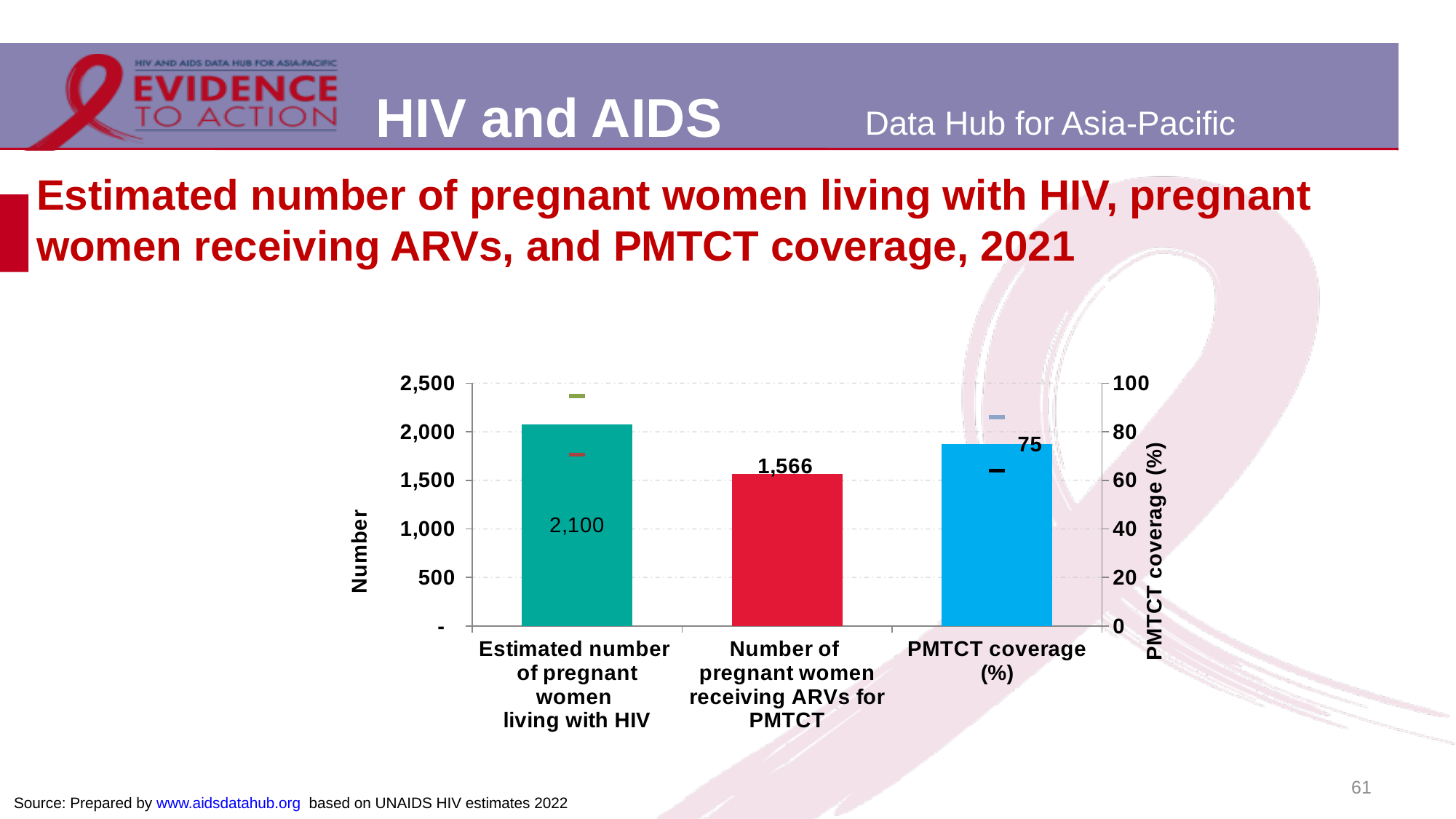
What is the PMTCT coverage (%) value shown on the chart? 75 What is the number of pregnant women receiving ARVs for PMTCT shown on the chart? 1,566 Which is larger: the estimated number of pregnant women living with HIV or the number of pregnant women receiving ARVs for PMTCT? Estimated number of pregnant women living with HIV Is the number of pregnant women receiving ARVs for PMTCT greater or less than 2,000? less Is the PMTCT coverage (%) value greater or less than 60 on the right-hand axis? greater What is the estimated number of pregnant women living with HIV shown on the chart? 2,100 What kind of chart is shown on the slide? Bar chart What is the title of the right-hand vertical axis of the chart? PMTCT coverage (%) What is the difference between the estimated number of pregnant women living with HIV and the number of pregnant women receiving ARVs for PMTCT? 534 Which category has the tallest bar on the chart? Estimated number of pregnant women living with HIV How many categories (bars) are plotted on the chart? 3 What is the title of the left-hand vertical axis of the chart? Number